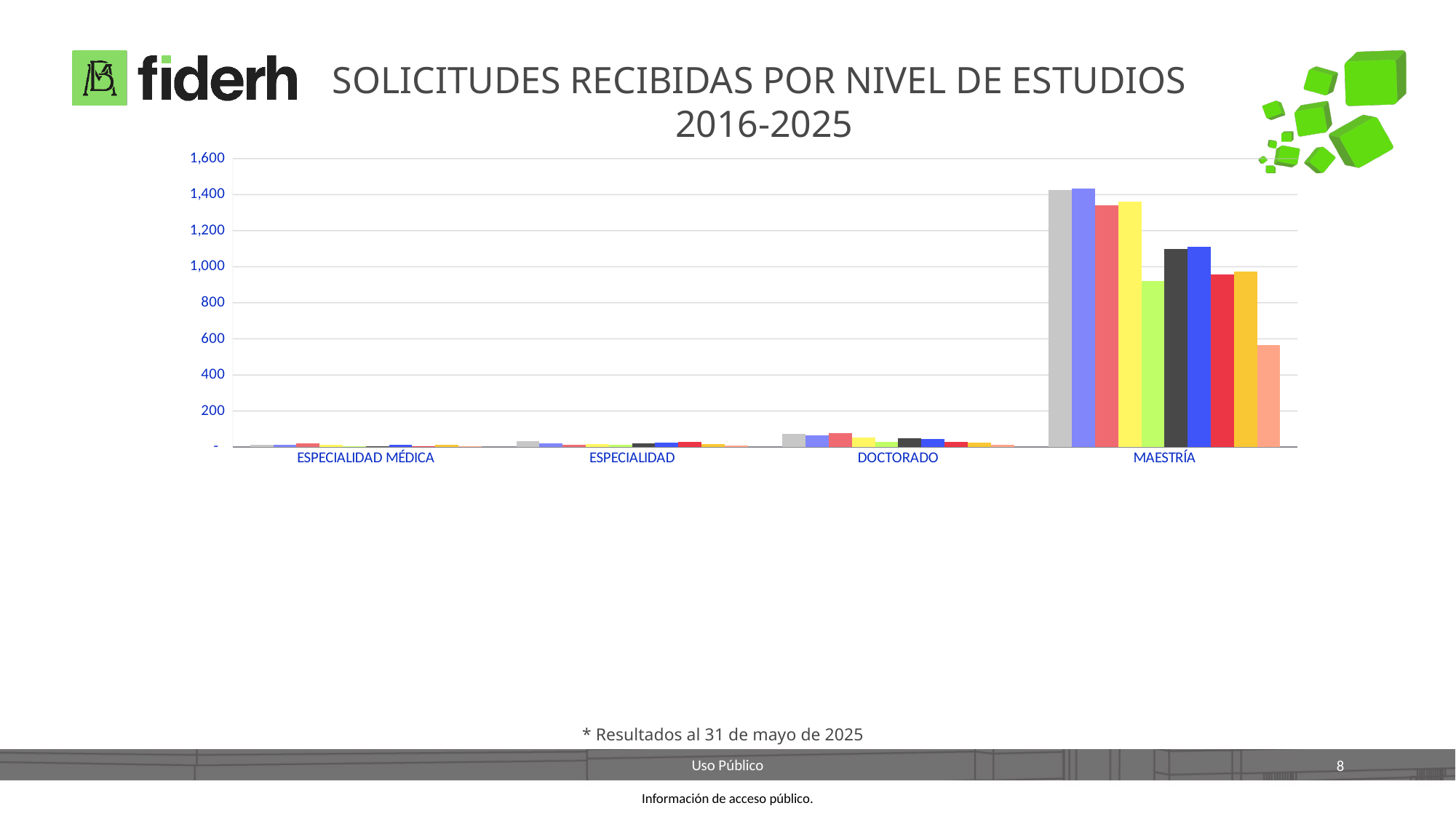
Are all the bars for ESPECIALIDAD greater or less than 200? less How many bars are plotted for the MAESTRÍA category? 10 Which category has the tallest bars in the chart? MAESTRÍA What kind of chart is shown on the slide? bar chart Which category has larger values, MAESTRÍA or DOCTORADO? MAESTRÍA Is the shortest bar for MAESTRÍA greater or less than 600? less Is the shortest bar for MAESTRÍA greater or less than 400? greater What is the highest value shown on the y axis of the chart? 1,600 What is the title of the chart? SOLICITUDES RECIBIDAS POR NIVEL DE ESTUDIOS 2016-2025 How many categories are shown on the x axis of the chart? 4